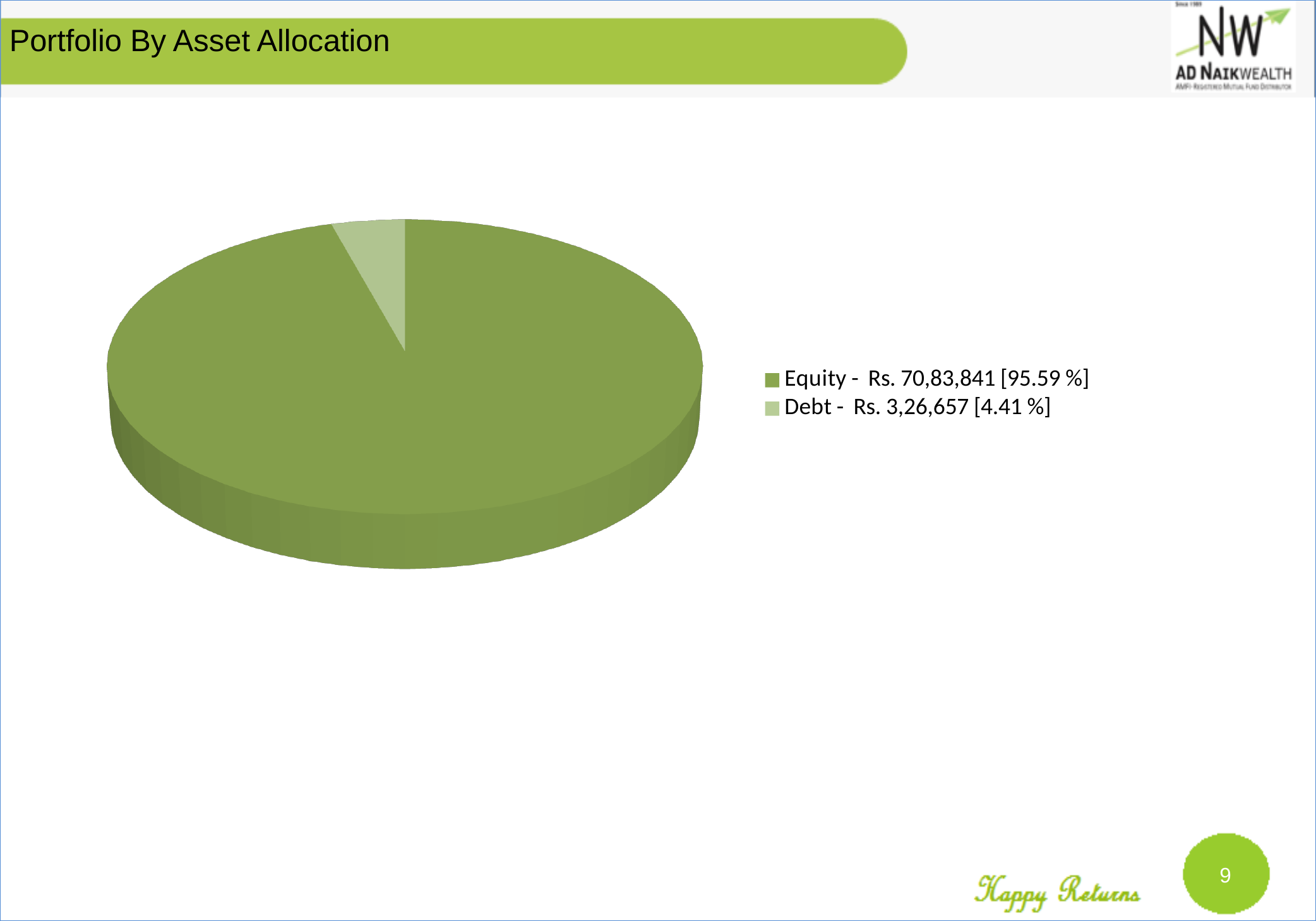
What share of the pie does Debt represent? 4.41 % What kind of chart is shown on the slide? Pie chart What share of the pie does Equity represent? 95.59 % What is the value for Debt? Rs. 3,26,657 What is the title of the slide containing the chart? Portfolio By Asset Allocation Which category has the smallest slice? Debt What is the value for Equity? Rs. 70,83,841 How many categories are shown in the pie chart? 2 Which category has the largest slice? Equity Which is larger, Equity or Debt? Equity What is the difference between the Equity and Debt values? Rs. 67,57,184 Which category is shown in the lighter green colour? Debt